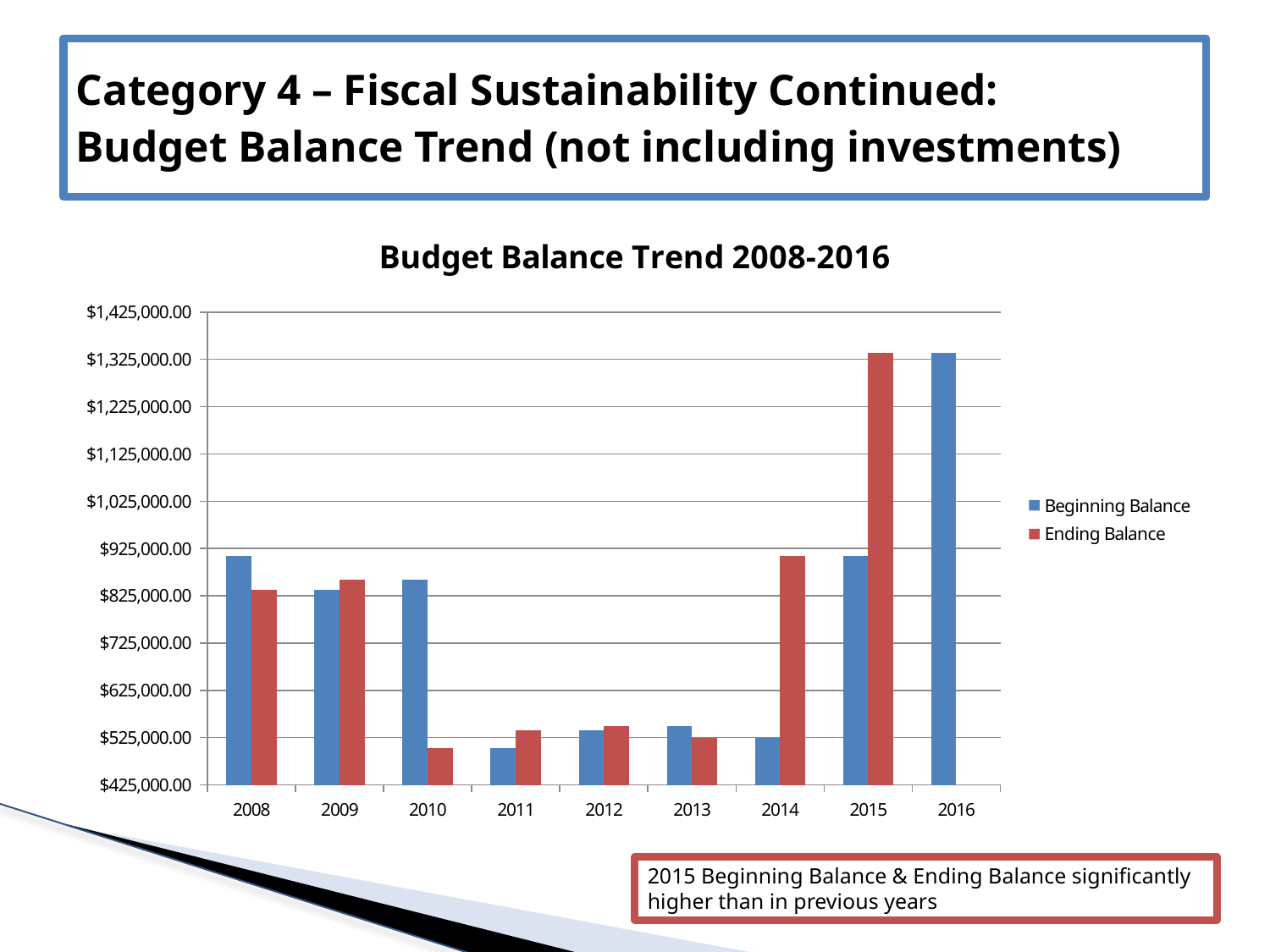
Is the Ending Balance for 2010 greater or less than $525,000.00? less Is the Ending Balance for 2015 greater or less than $1,225,000.00? greater In 2014, which is larger, the Beginning Balance or the Ending Balance? Ending Balance Is the Beginning Balance for 2014 greater or less than $625,000.00? less In 2008, which is larger, the Beginning Balance or the Ending Balance? Beginning Balance Does the Ending Balance rise or fall from 2013 to 2015? Rises What is the title of the chart? Budget Balance Trend 2008-2016 Which year has the highest Beginning Balance? 2016 How many years are shown on the x axis? 9 What kind of chart is shown on the slide? Bar chart How many series does the legend list? 2 Which year has the highest Ending Balance? 2015